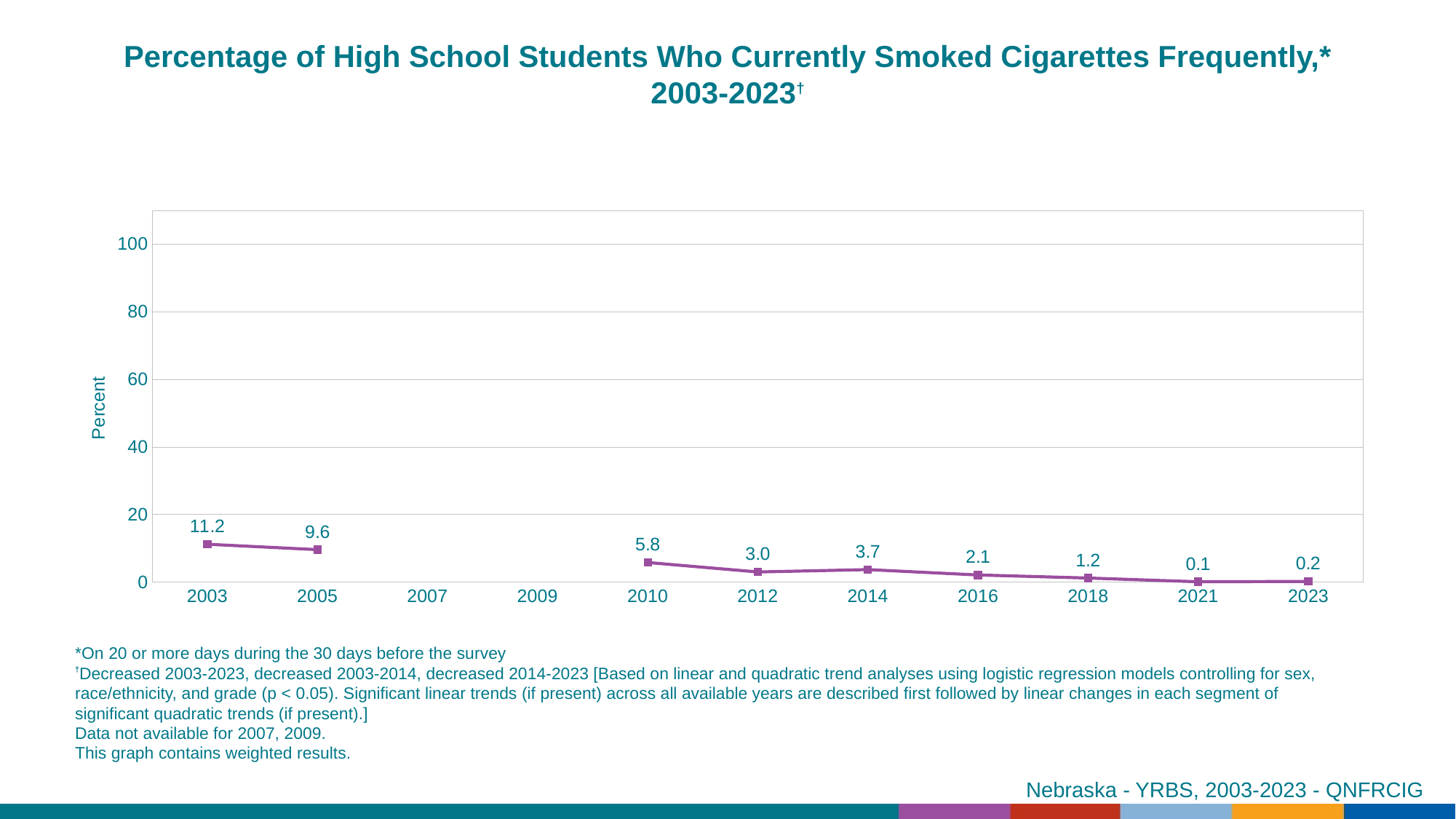
Which is larger, the value for 2012 or the value for 2014? 2014 What kind of chart is shown on the slide? line chart What value is shown for 2021? 0.1 What was the percentage of high school students who currently smoked cigarettes frequently in 2003? 11.2 Which year has the highest value on the chart? 2003 Is the value for 2003 greater or less than 20? less What is the difference between the values for 2010 and 2012? 2.8 Which year has the lowest value on the chart? 2021 What value is shown for 2014? 3.7 Do the values generally rise or fall from 2003 to 2023? fall What is the difference between the values for 2003 and 2005? 1.6 How many years have data points plotted on the chart? 9